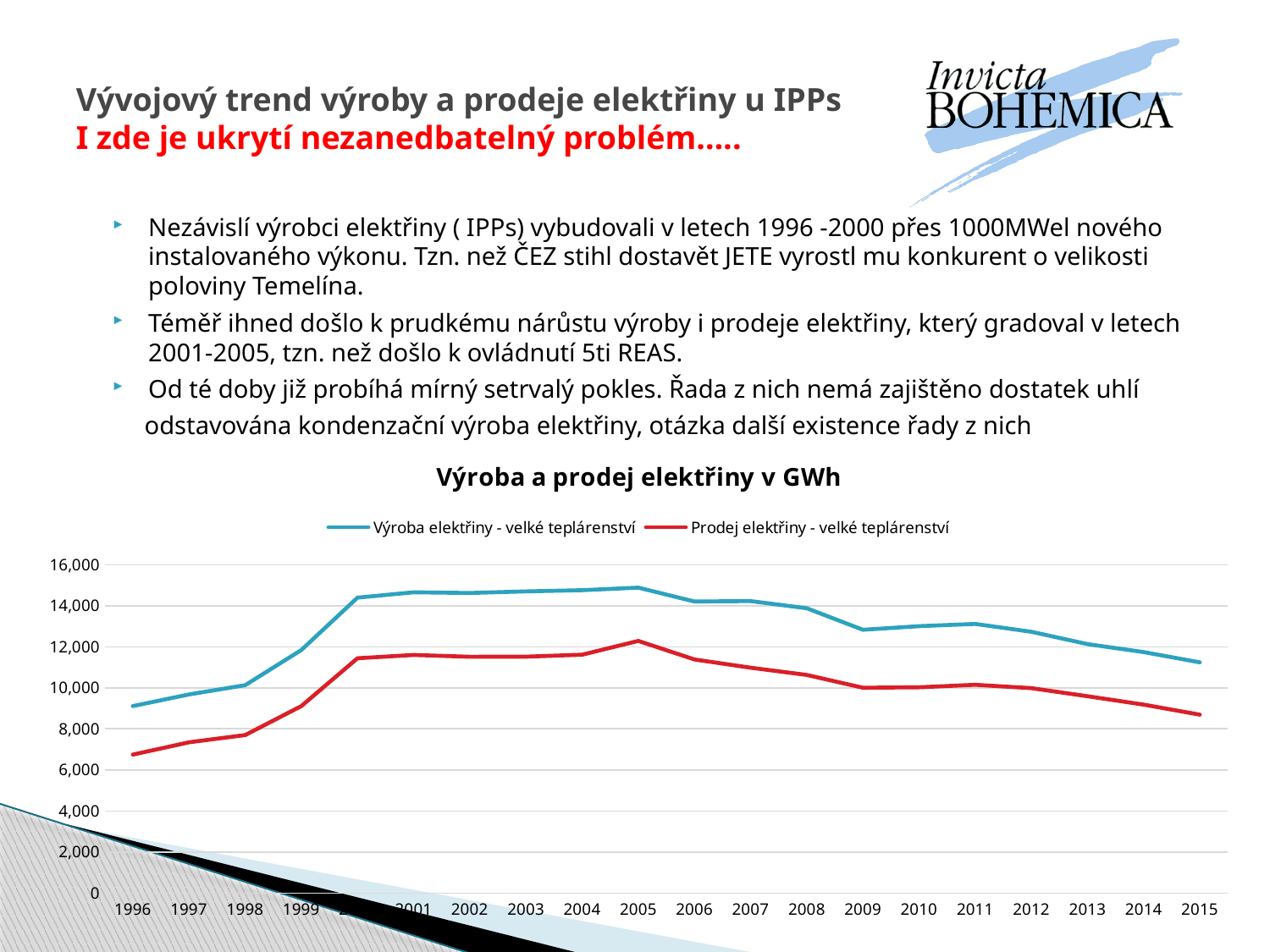
What kind of chart is shown on the slide? line chart In 2005, which series has the larger value: Výroba elektřiny - velké teplárenství or Prodej elektřiny - velké teplárenství? Výroba elektřiny - velké teplárenství Which series is drawn in red? Prodej elektřiny - velké teplárenství What is the title of the chart? Výroba a prodej elektřiny v GWh How many series does the legend list? 2 Is the value for Prodej elektřiny - velké teplárenství in 2005 greater or less than 12,000? greater Is the value for Výroba elektřiny - velké teplárenství in 1996 greater or less than 10,000? less In which year is the Výroba elektřiny - velké teplárenství series at its lowest? 1996 In which year does the Prodej elektřiny - velké teplárenství series reach its highest value? 2005 Is the value for Výroba elektřiny - velké teplárenství in 2015 greater or less than 12,000? less How many years are plotted along the x axis? 20 Do the values of Výroba elektřiny - velké teplárenství rise or fall from 2005 to 2015? fall